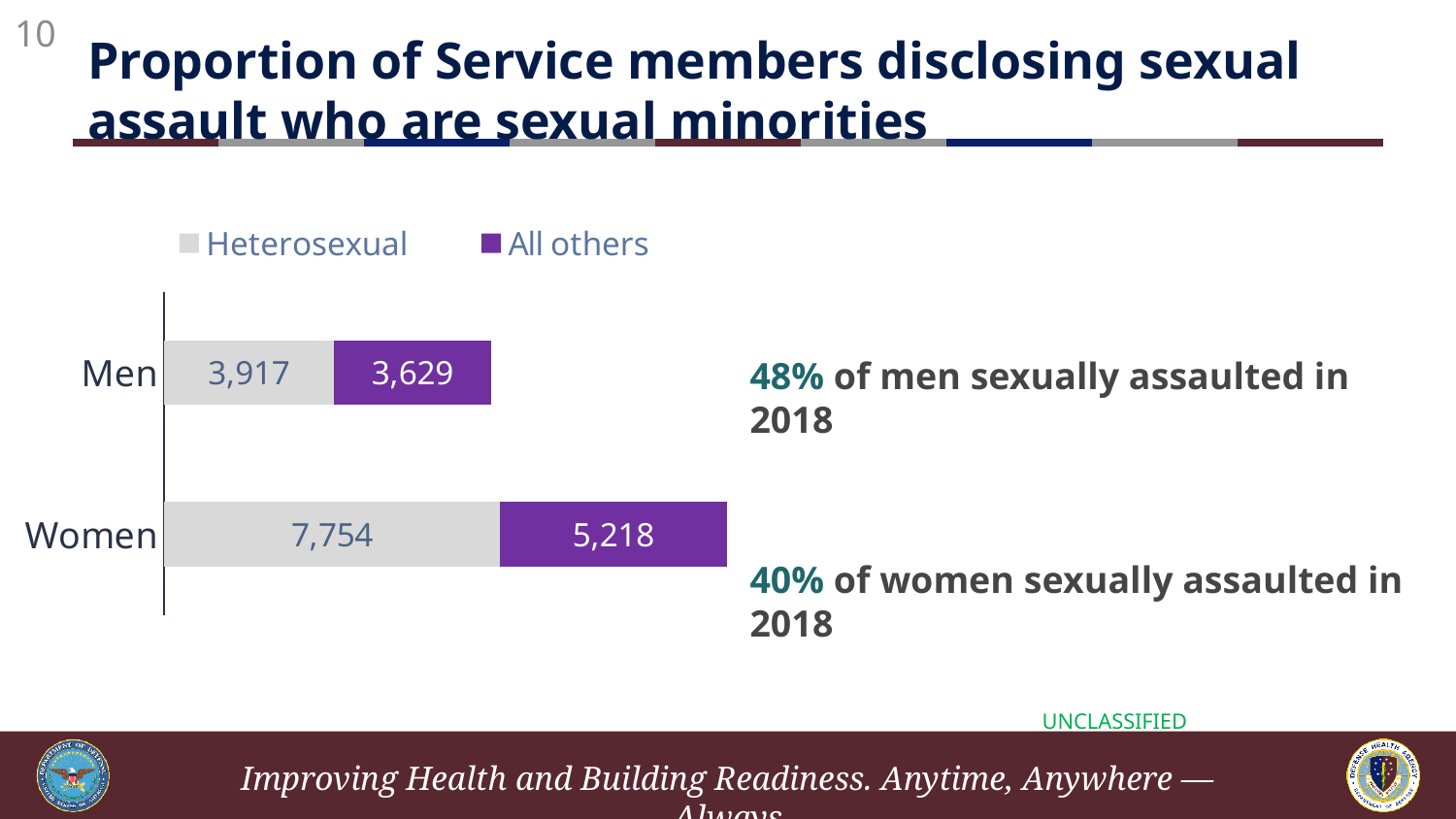
How many series does the legend list? 2 How many categories are shown on the chart? 2 What kind of chart is shown on the slide? Stacked bar chart What is the total of the stacked bar for Women? 12,972 What is the difference between the Heterosexual and All others values for Women? 2,536 What is the Heterosexual value for Men? 3,917 Which category has the larger Heterosexual value, Men or Women? Women What is the Heterosexual value for Women? 7,754 What is the difference between the All others values for Women and Men? 1,589 What is the All others value for Women? 5,218 What is the All others value for Men? 3,629 What is the total of the stacked bar for Men? 7,546